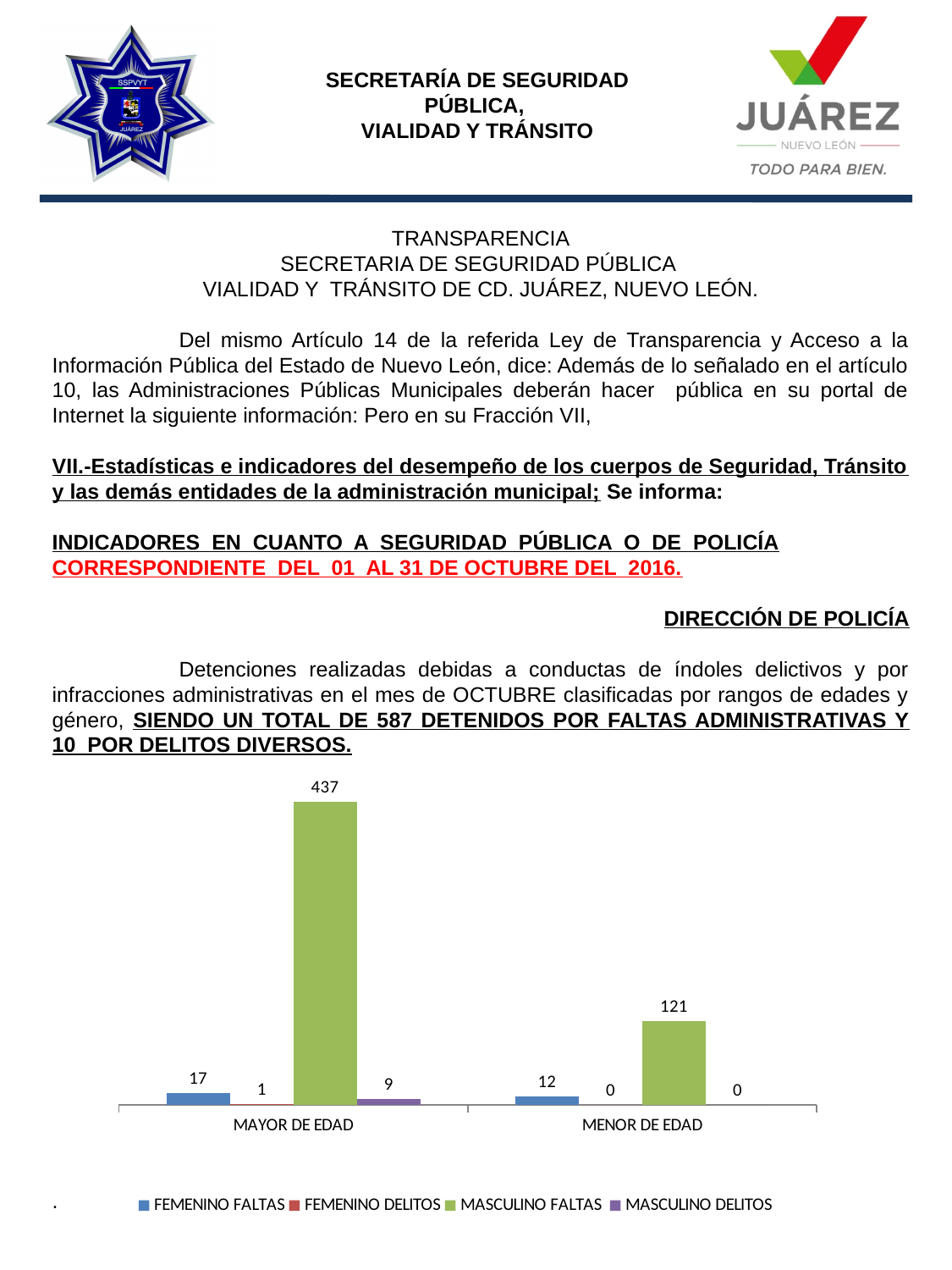
What is the difference between FEMENINO FALTAS and MASCULINO DELITOS in the MAYOR DE EDAD category? 8 Which is larger: FEMENINO FALTAS for MAYOR DE EDAD or FEMENINO FALTAS for MENOR DE EDAD? MAYOR DE EDAD What is the value for MASCULINO FALTAS in the MAYOR DE EDAD category? 437 Which series has the highest value in the MENOR DE EDAD category? MASCULINO FALTAS What is the value for FEMENINO FALTAS in the MENOR DE EDAD category? 12 What kind of chart is shown on the slide? Bar chart How many categories are shown on the x axis of the chart? 2 Which colour represents MASCULINO FALTAS in the chart legend? Green What is the difference between MASCULINO FALTAS for MAYOR DE EDAD and MASCULINO FALTAS for MENOR DE EDAD? 316 How many series does the chart legend list? 4 What is the value for MASCULINO DELITOS in the MAYOR DE EDAD category? 9 What is the value for FEMENINO DELITOS in the MENOR DE EDAD category? 0